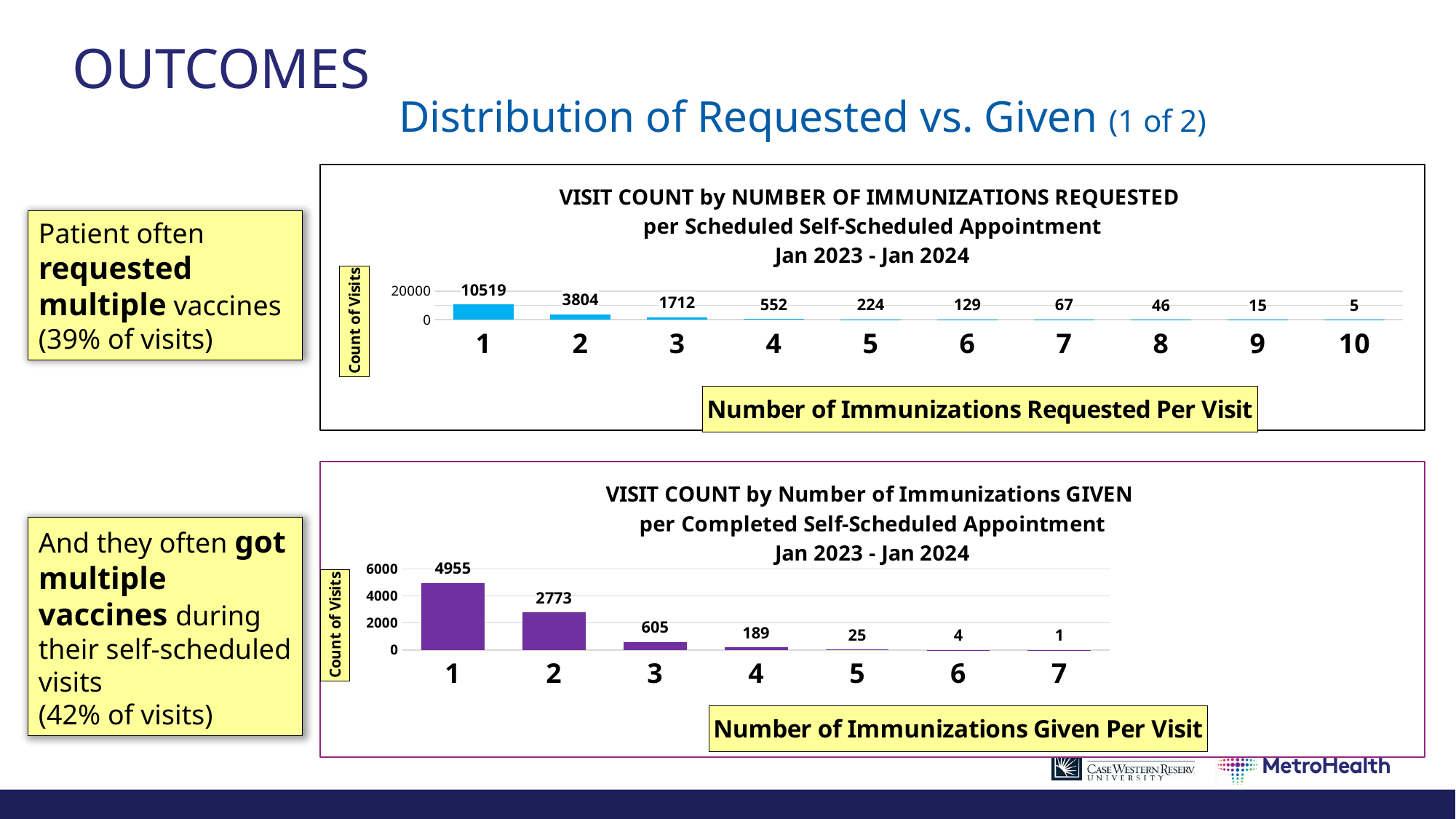
In the top chart (Visit Count by Number of Immunizations Requested), what is the visit count for 4 immunizations requested? 552 In the top chart (Visit Count by Number of Immunizations Requested), what is the difference between the visit counts for 2 and 3 immunizations requested? 2092 In the bottom chart (Visit Count by Number of Immunizations Given), what is the visit count for 5 immunizations given? 25 In the top chart (Visit Count by Number of Immunizations Requested), do the visit counts rise or fall as the number of immunizations requested increases? fall In the top chart (Visit Count by Number of Immunizations Requested), what is the visit count for 1 immunization requested? 10519 In the top chart (Visit Count by Number of Immunizations Requested), which number of immunizations requested has the lowest visit count? 10 What kind of chart is the bottom chart (Visit Count by Number of Immunizations Given)? bar chart In the bottom chart (Visit Count by Number of Immunizations Given), which number of immunizations given has the highest visit count? 1 In the bottom chart (Visit Count by Number of Immunizations Given), how many categories are shown on the x axis? 7 In the bottom chart (Visit Count by Number of Immunizations Given), what is the difference between the visit counts for 1 and 2 immunizations given? 2182 In the top chart (Visit Count by Number of Immunizations Requested), how many categories are shown on the x axis? 10 In the bottom chart (Visit Count by Number of Immunizations Given), what is the visit count for 2 immunizations given? 2773